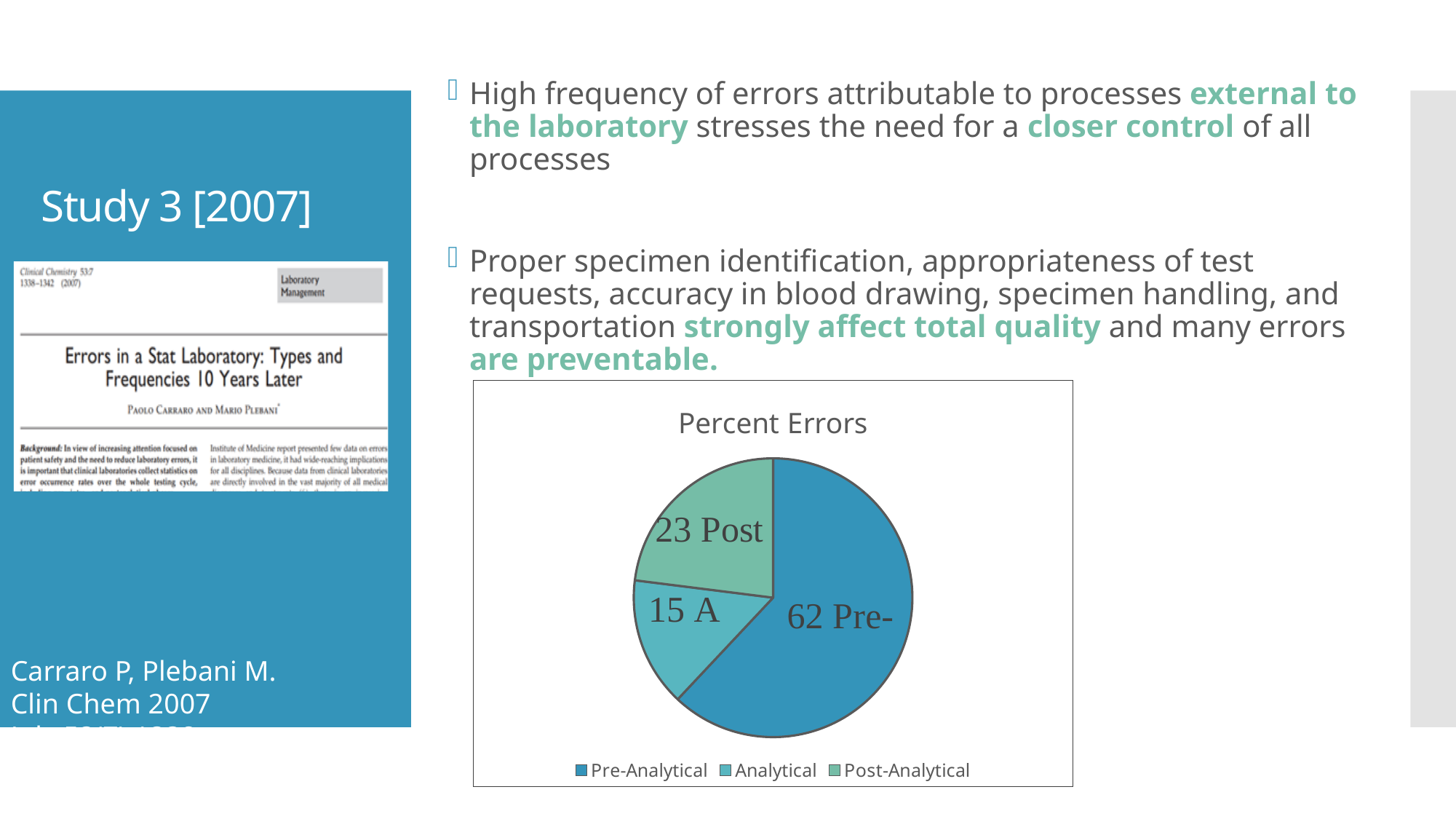
How many slices does the pie chart have? 3 What value is shown for the Post-Analytical slice? 23 What is the difference between the Pre-Analytical and Post-Analytical values? 39 What type of chart is shown on the slide? pie chart What value is shown for the Analytical slice? 15 Which category has the smallest slice of the pie? Analytical What is the difference between the Post-Analytical and Analytical values? 8 Which category has the largest slice of the pie? Pre-Analytical How many entries does the legend list? 3 Which is larger, the Post-Analytical slice or the Analytical slice? Post-Analytical What value is shown for the Pre-Analytical slice? 62 What is the title of the chart? Percent Errors